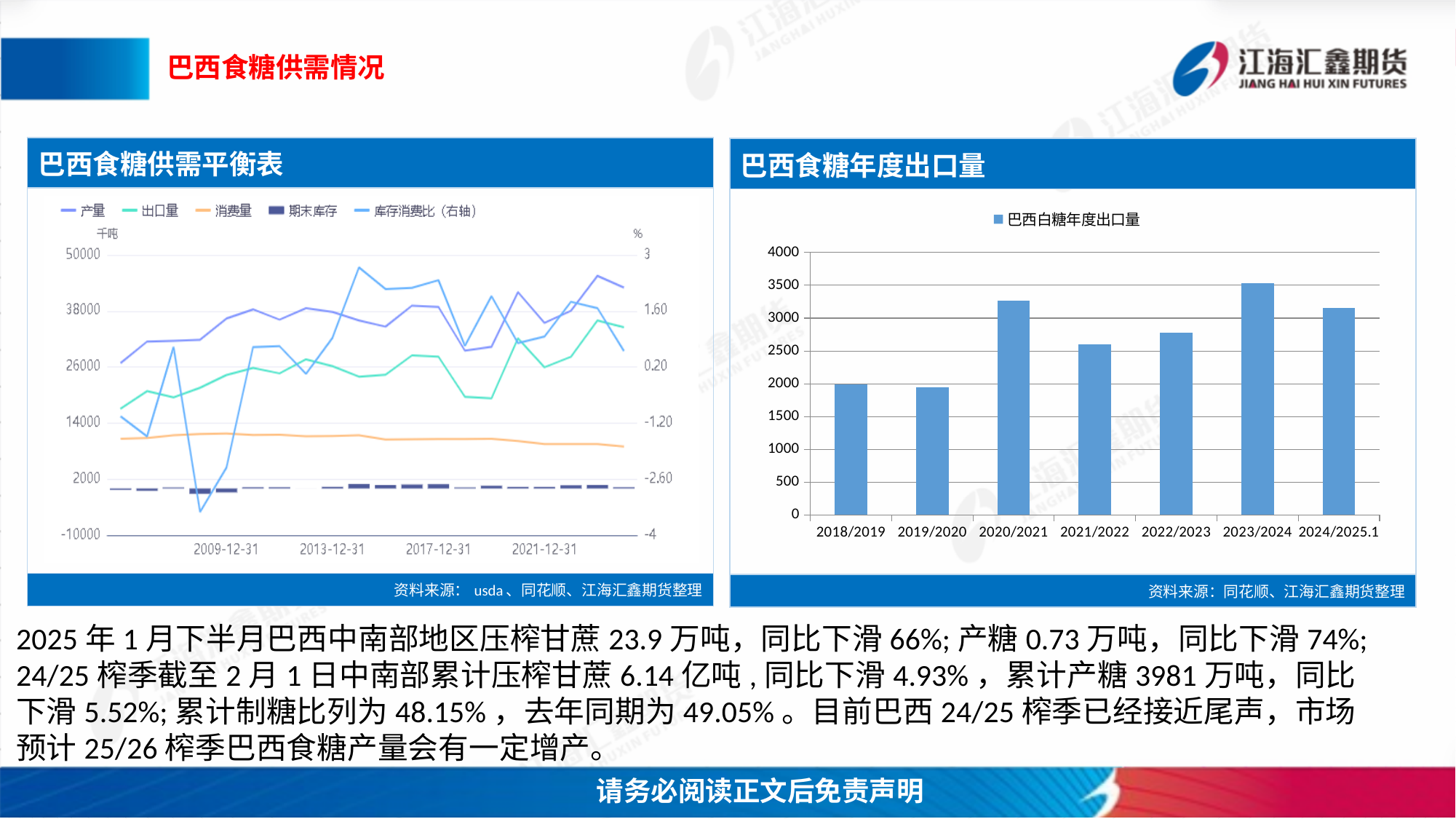
What kind of chart is the right-hand chart titled 巴西食糖年度出口量? bar chart In the chart 巴西食糖年度出口量, how many categories (seasons) are shown on the x axis? 7 How many series does the legend of the chart 巴西食糖年度出口量 list? 1 In the chart 巴西食糖年度出口量, is the value for 2020/2021 greater or less than 3000? greater In the chart 巴西食糖年度出口量, which is larger, the value for 2020/2021 or the value for 2021/2022? 2020/2021 How many series does the legend of the chart 巴西食糖供需平衡表 list? 5 In the chart 巴西食糖年度出口量, is the value for 2022/2023 greater or less than 3000? less In the chart 巴西食糖供需平衡表, which series is plotted on the right axis according to the legend? 库存消费比 In the chart 巴西食糖年度出口量, which season has the highest export volume? 2023/2024 What kind of chart is the left-hand chart titled 巴西食糖供需平衡表? line chart In the chart 巴西食糖年度出口量, is the value for 2018/2019 greater or less than 2500? less In the chart 巴西食糖年度出口量, which is larger, the value for 2023/2024 or the value for 2024/2025.1? 2023/2024